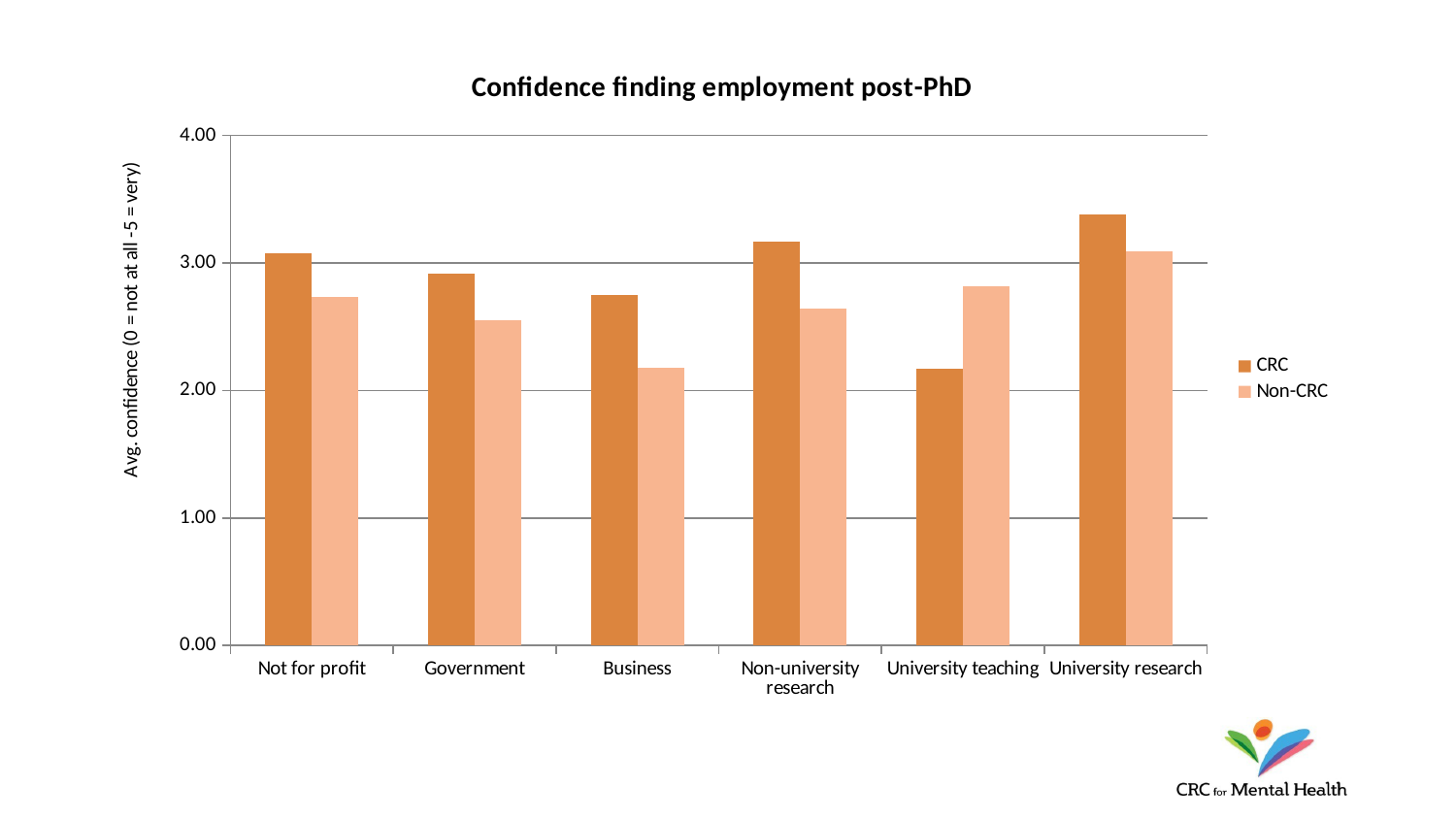
What kind of chart is shown on the slide? Bar chart Which category has the highest CRC value? University research How many employment categories are shown on the x axis? 6 Which category has the highest Non-CRC value? University research Is the Non-CRC value for Business greater or less than 2.00? greater Is the CRC value for University teaching greater or less than 3.00? less How many series does the legend list? 2 Which category has the lowest CRC value? University teaching For University teaching, which is larger: the CRC value or the Non-CRC value? Non-CRC Which category has the lowest Non-CRC value? Business For Business, which is larger: the CRC value or the Non-CRC value? CRC What is the title of the chart? Confidence finding employment post-PhD